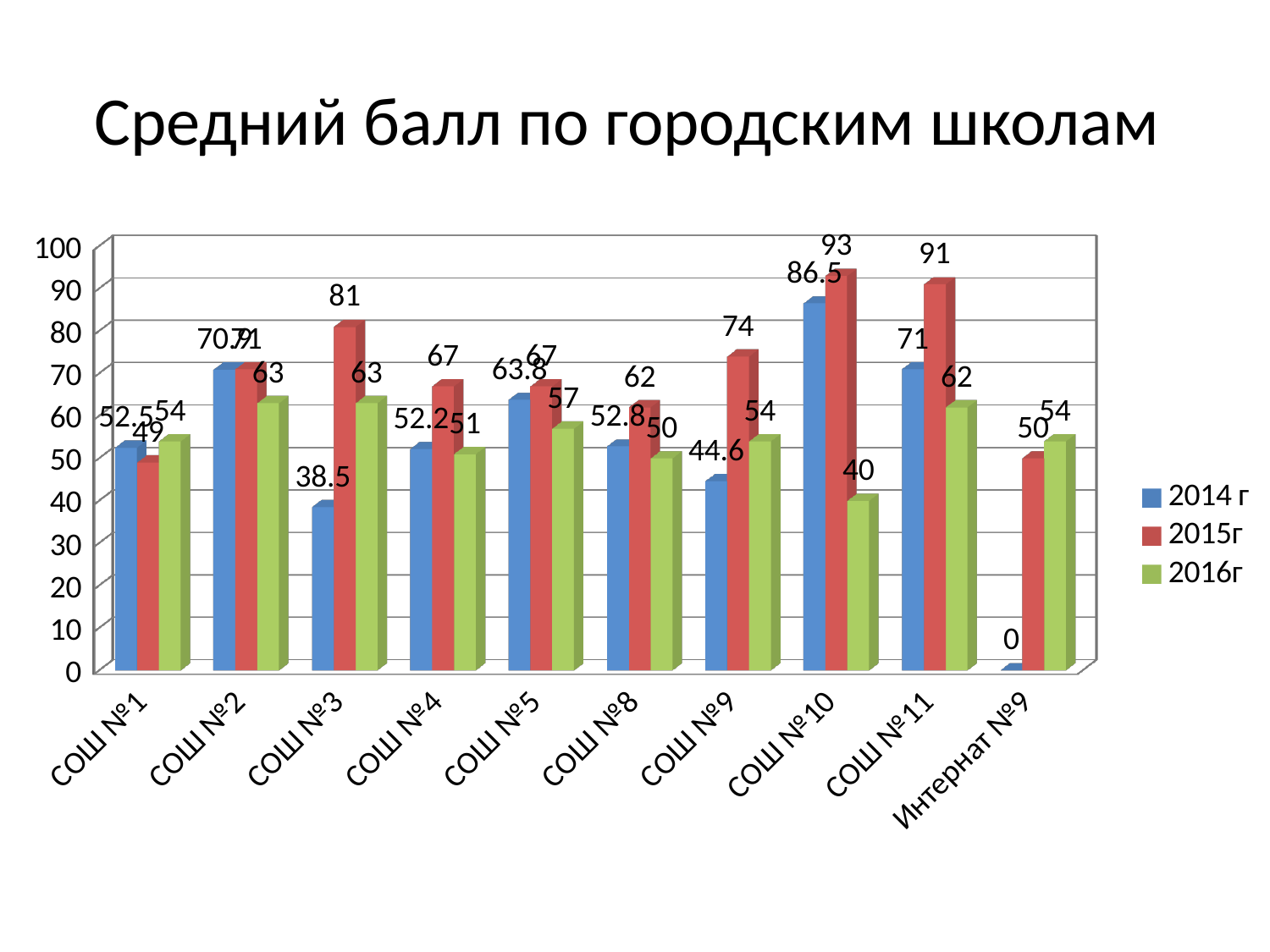
What is the 2014 г value for СОШ №9? 44.6 Is the 2015г value for СОШ №11 greater or less than 80? greater What kind of chart is shown on the slide? bar chart Which school has the lowest 2014 г value? Интернат №9 How many schools (categories) are shown on the x axis? 10 How many series does the legend list? 3 What is the 2015г value for СОШ №3? 81 Which school has the highest 2015г value? СОШ №10 What is the title of the chart? Средний балл по городским школам For СОШ №9, which series has the larger value, 2014 г or 2015г? 2015г What is the difference between the 2015г and 2016г values for СОШ №10? 53 What is the 2016г value for СОШ №10? 40